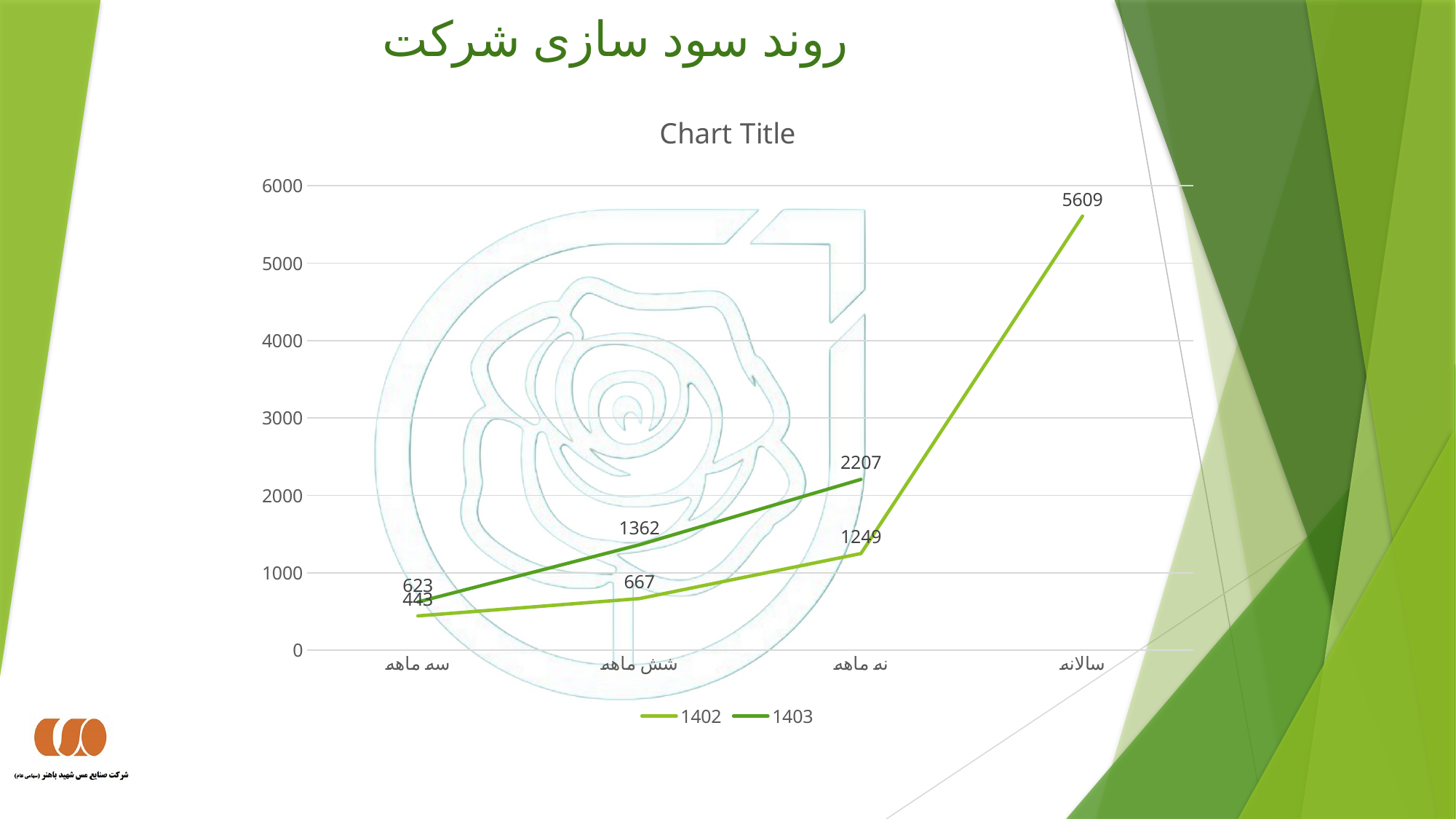
What is the value of the 1402 series for سه ماهه? 443 Do the values of the 1402 series rise or fall from سه ماهه to سالانه? rise For شش ماهه, which series has the larger value, 1402 or 1403? 1403 What is the value of the 1403 series for نه ماهه? 2207 Which category has the lowest value for the 1403 series? سه ماهه What kind of chart is shown on the slide? line chart Which category has the highest value for the 1402 series? سالانه What is the value of the 1403 series for شش ماهه? 1362 What is the value of the 1402 series for سالانه? 5609 What is the difference between the 1403 and 1402 values for نه ماهه? 958 How many categories are shown on the x axis? 4 How many series does the legend list? 2